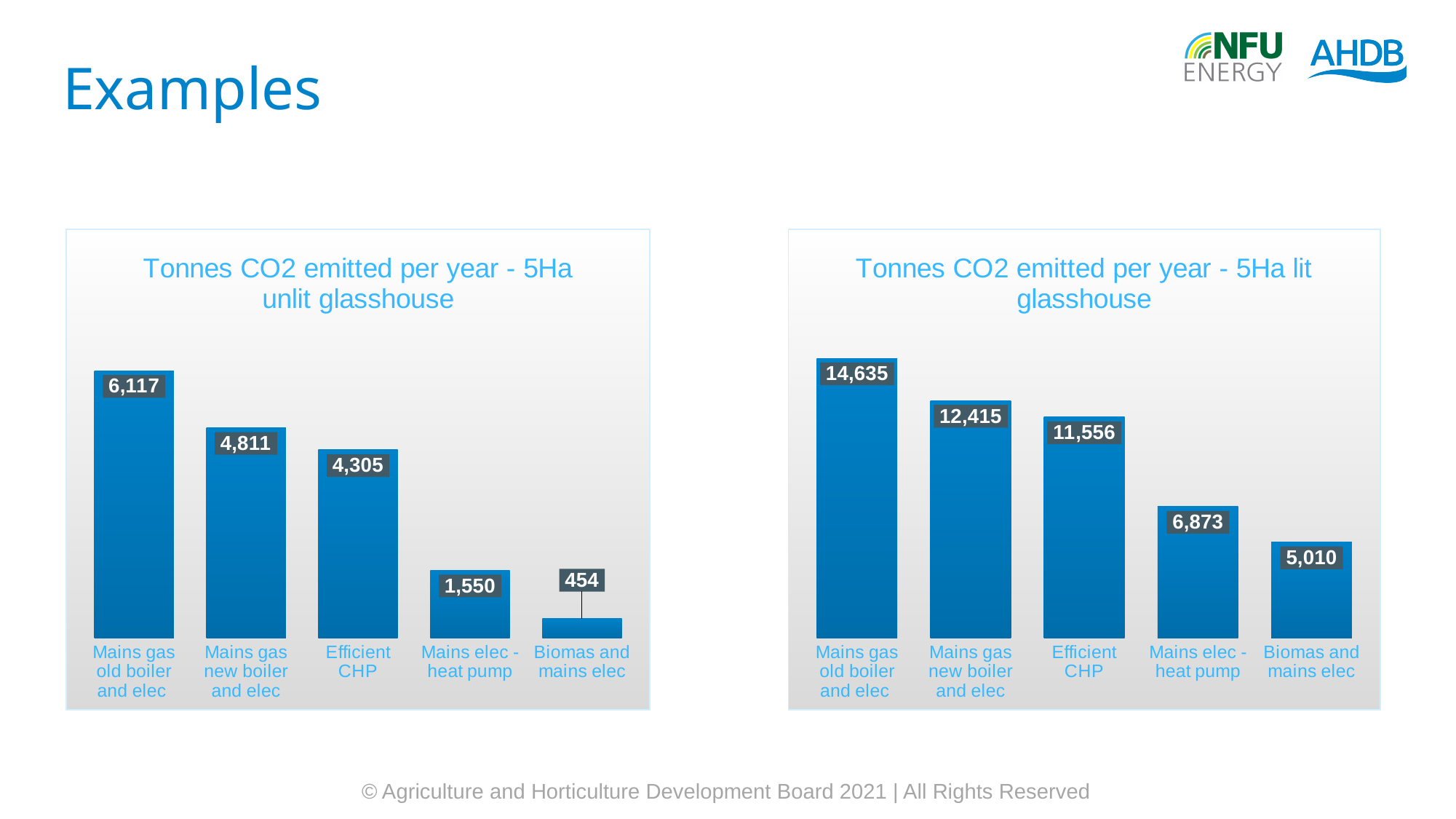
How many categories are shown in the left chart (5Ha unlit glasshouse)? 5 In the right chart (5Ha lit glasshouse), what is the value for Mains elec - heat pump? 6,873 What type of chart is the right chart (5Ha lit glasshouse)? Bar chart In the left chart (5Ha unlit glasshouse), what is the value for Efficient CHP? 4,305 In the right chart (5Ha lit glasshouse), which is larger: Mains gas new boiler and elec or Efficient CHP? Mains gas new boiler and elec What is the title of the right chart? Tonnes CO2 emitted per year - 5Ha lit glasshouse In the right chart (5Ha lit glasshouse), what is the difference between Efficient CHP and Biomas and mains elec? 6,546 In the left chart (5Ha unlit glasshouse), what is the difference between Mains gas old boiler and elec and Mains gas new boiler and elec? 1,306 In the left chart (5Ha unlit glasshouse), what is the value for Mains elec - heat pump? 1,550 In the left chart (5Ha unlit glasshouse), which category has the lowest value? Biomas and mains elec In the right chart (5Ha lit glasshouse), which category has the highest value? Mains gas old boiler and elec In the left chart (5Ha unlit glasshouse), do the values rise or fall from left to right across the categories? Fall